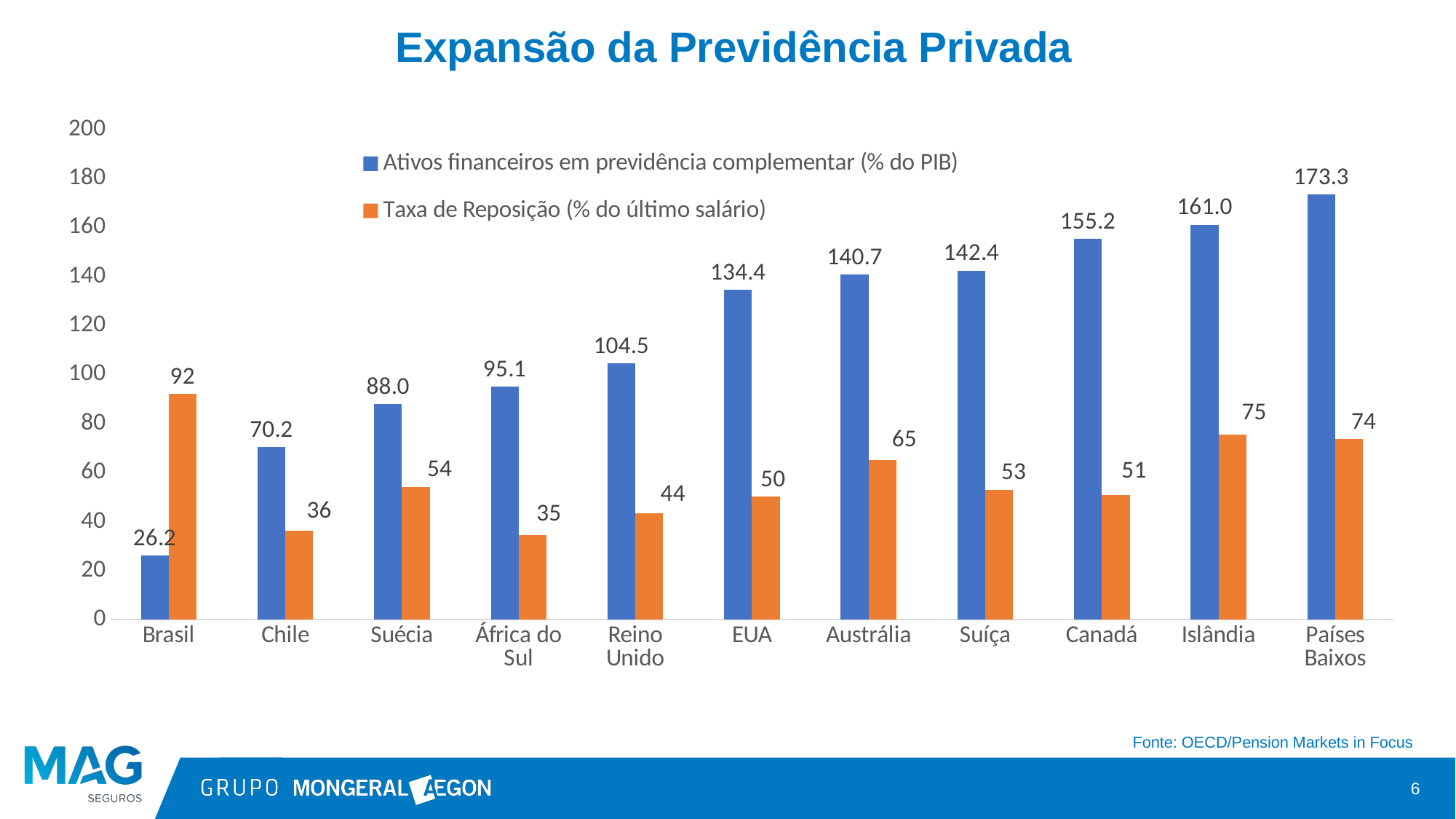
What is the value of 'Ativos financeiros em previdência complementar (% do PIB)' for Brasil? 26.2 Is the 'Ativos financeiros em previdência complementar' value for EUA greater or less than 120? greater What is the difference between the 'Ativos financeiros em previdência complementar' values for Islândia and Canadá? 5.8 How many countries are shown on the x axis? 11 Which country has the highest value for 'Ativos financeiros em previdência complementar (% do PIB)'? Países Baixos Which country has the lowest 'Taxa de Reposição (% do último salário)'? África do Sul How many series does the legend list? 2 What is the title of the chart? Expansão da Previdência Privada What is the 'Taxa de Reposição (% do último salário)' for Austrália? 65 Do the 'Ativos financeiros em previdência complementar (% do PIB)' values rise or fall from Brasil to Países Baixos? Rise Which is larger: the 'Taxa de Reposição' for Brasil or for Países Baixos? Brasil What kind of chart is shown on the slide? Bar chart